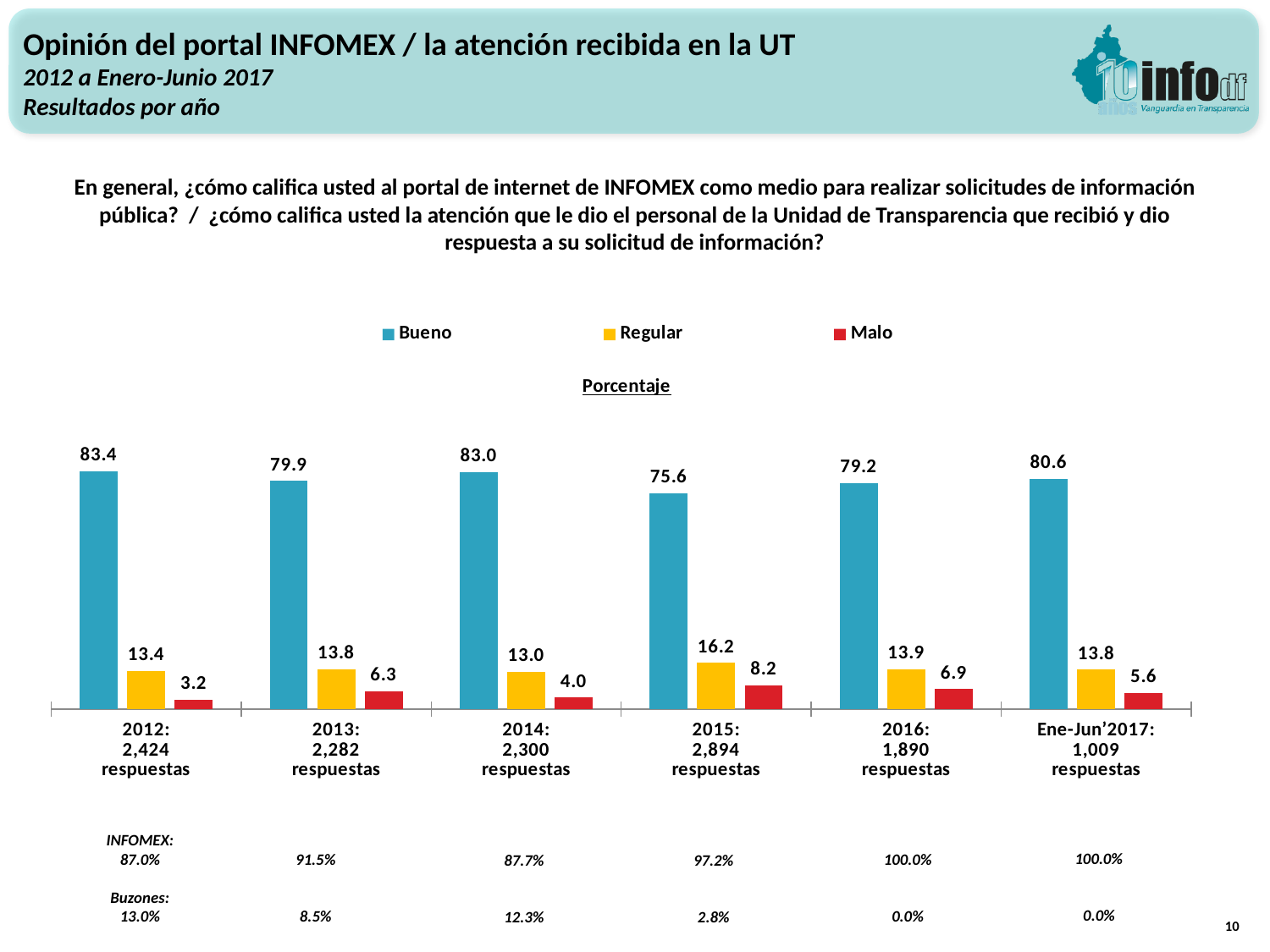
What is the value for Malo in 2015? 8.2 How many year categories are shown on the x axis? 6 In which year is the Bueno value highest? 2012 What kind of chart is shown on the slide? bar chart In which year is the Bueno value lowest? 2015 How many series does the legend list? 3 What is the value for Bueno in 2012? 83.4 In which year is the Malo value highest? 2015 What is the value for Regular in Ene-Jun'2017? 13.8 Which colour represents the Malo series in the legend? red What is the difference between the Bueno values for 2014 and 2015? 7.4 Which is larger, the Regular value for 2015 or the Regular value for 2016? 2015